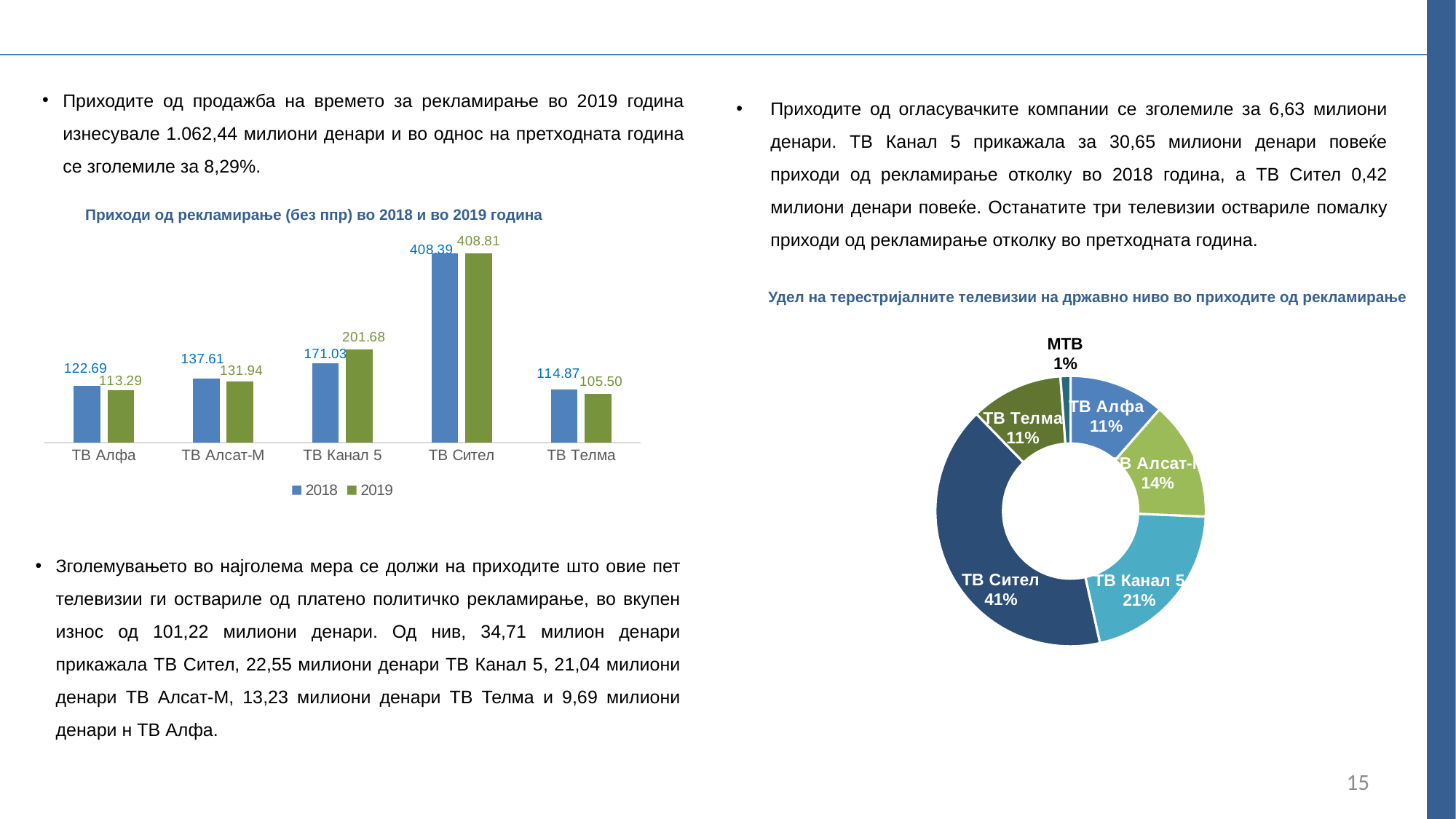
In the chart 'Удел на терестријалните телевизии на државно ниво во приходите од рекламирање', how many TV stations are shown? 6 In the bar chart 'Приходи од рекламирање (без ппр) во 2018 и во 2019 година', how many series does the legend list? 2 What kind of chart is the chart on the left of the slide? bar chart In the bar chart 'Приходи од рекламирање (без ппр) во 2018 и во 2019 година', how many TV stations are shown on the x axis? 5 In the bar chart 'Приходи од рекламирање (без ппр) во 2018 и во 2019 година', which TV station has the highest 2019 value? ТВ Сител In the bar chart 'Приходи од рекламирање (без ппр) во 2018 и во 2019 година', which TV station has the lowest 2019 value? ТВ Телма In the bar chart 'Приходи од рекламирање (без ппр) во 2018 и во 2019 година', what is the 2018 value for ТВ Алфа? 122.69 In the bar chart 'Приходи од рекламирање (без ппр) во 2018 и во 2019 година', what is the difference between the 2019 and 2018 values for ТВ Канал 5? 30.65 In the bar chart 'Приходи од рекламирање (без ппр) во 2018 и во 2019 година', is the 2018 value for ТВ Алсат-М larger or smaller than its 2019 value? larger In the bar chart 'Приходи од рекламирање (без ппр) во 2018 и во 2019 година', what is the 2019 value for ТВ Канал 5? 201.68 In the chart 'Удел на терестријалните телевизии на државно ниво во приходите од рекламирање', what share does ТВ Сител have? 41% In the chart 'Удел на терестријалните телевизии на државно ниво во приходите од рекламирање', which TV station has the smallest share? МТВ